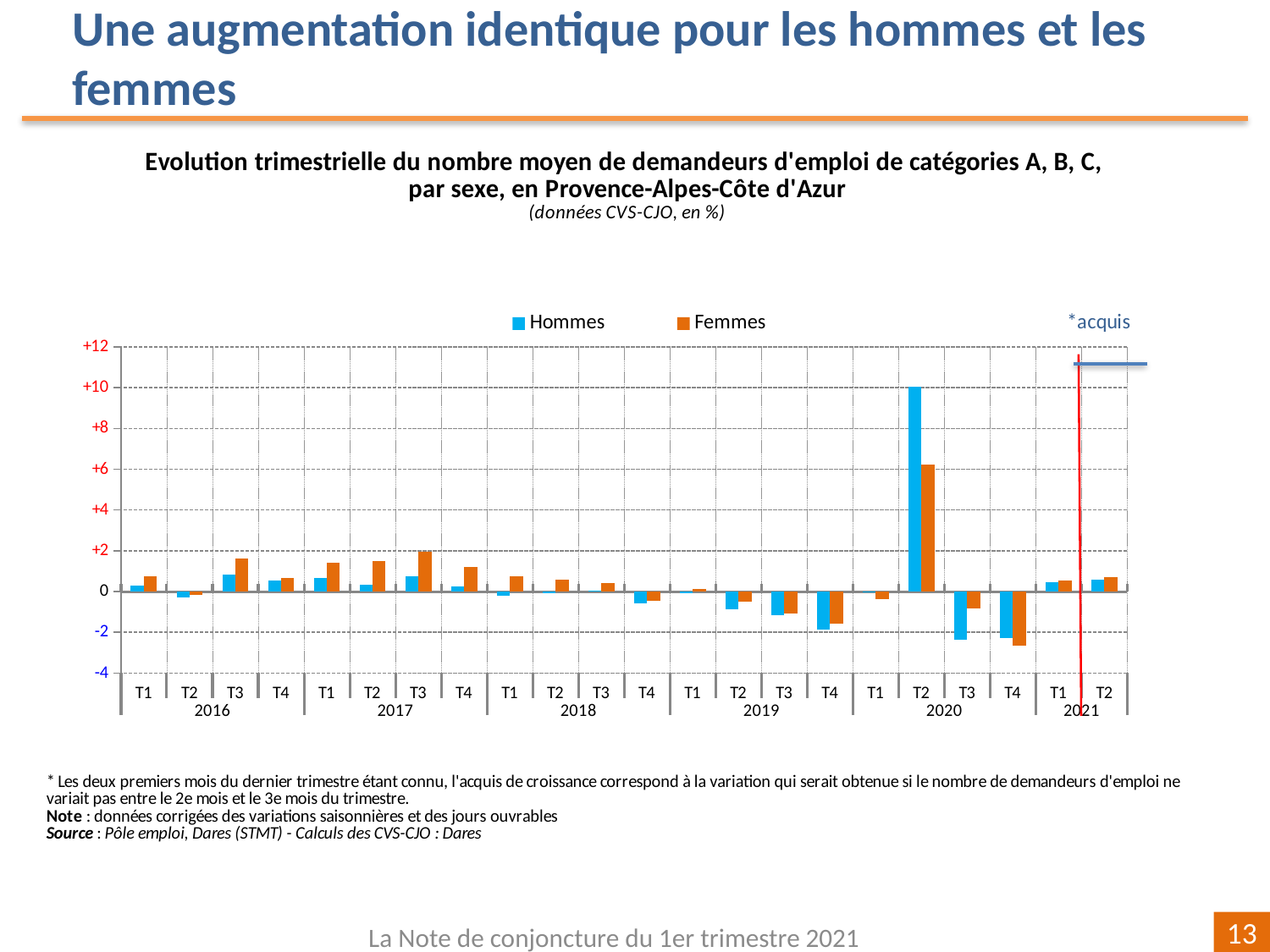
Is the value for Femmes in T4 2020 greater or less than -2? less Which colour represents the Femmes series in the legend? orange In which quarter is the Femmes series at its highest? T2 2020 Is the value for Femmes in T2 2020 greater or less than +8? less How many series does the legend list? 2 What kind of chart is shown on the slide? bar chart In which quarter is the Femmes series at its lowest? T4 2020 How many quarters are plotted along the x axis? 22 In T3 2016, which series has the larger value, Hommes or Femmes? Femmes Is the value for Hommes in T2 2020 greater or less than +8? greater In T2 2020, which series has the larger value, Hommes or Femmes? Hommes In which quarter is the Hommes series at its highest? T2 2020